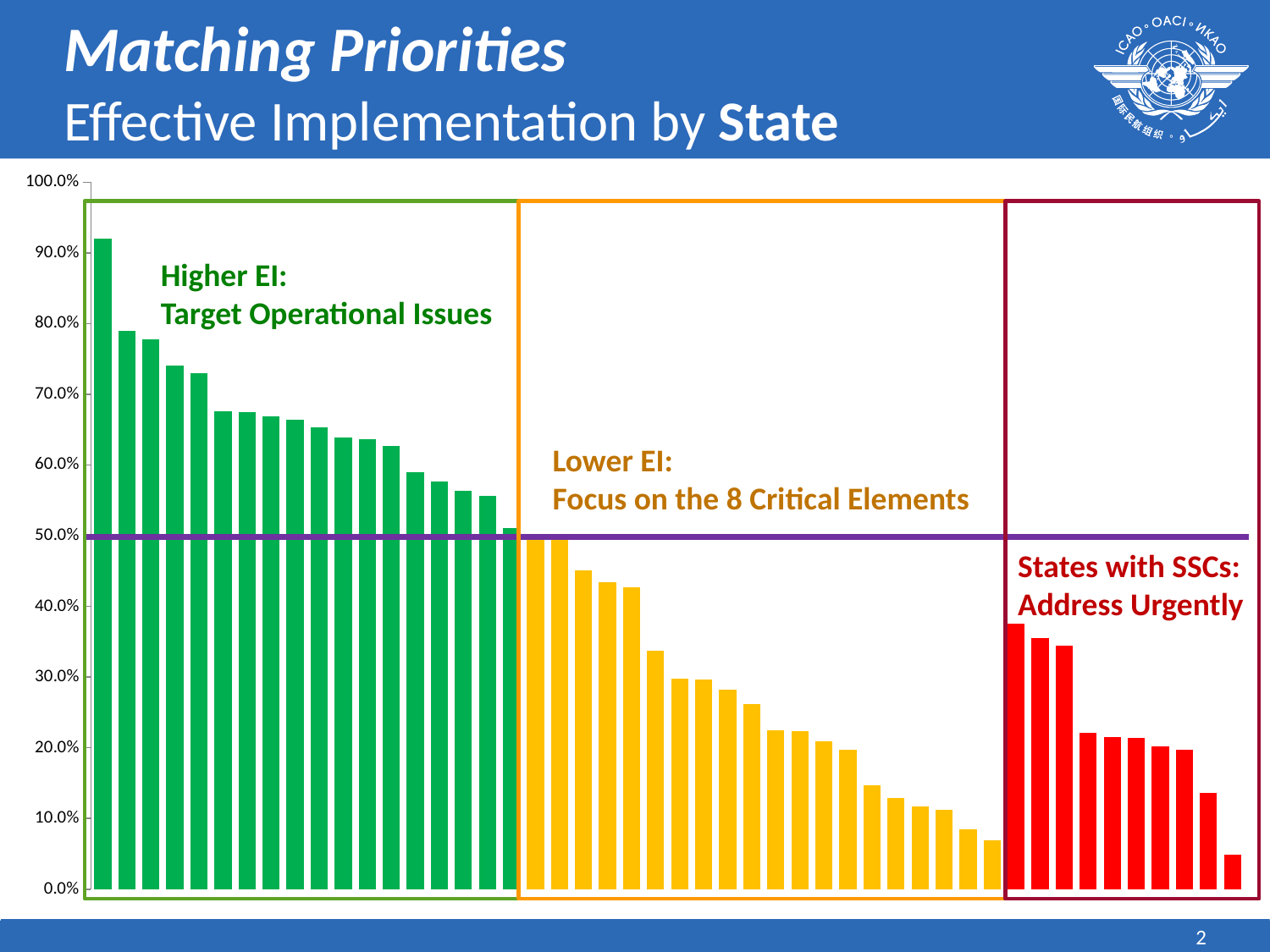
Is the tallest red bar taller or shorter than the tallest yellow bar? shorter What label is written in the green section of the chart? Higher EI: Target Operational Issues Is the value of the tallest red bar greater or less than 40%? less Is the value of the leftmost (tallest) bar greater or less than 80%? greater What value on the y-axis does the horizontal purple line mark? 50.0% Which colour group contains the tallest bar in the chart? green Into how many colour-coded groups are the bars divided? 3 Which colour group contains the shortest bar in the chart? red What type of chart is shown on the slide? bar chart Is the value of the rightmost bar greater or less than 10%? less